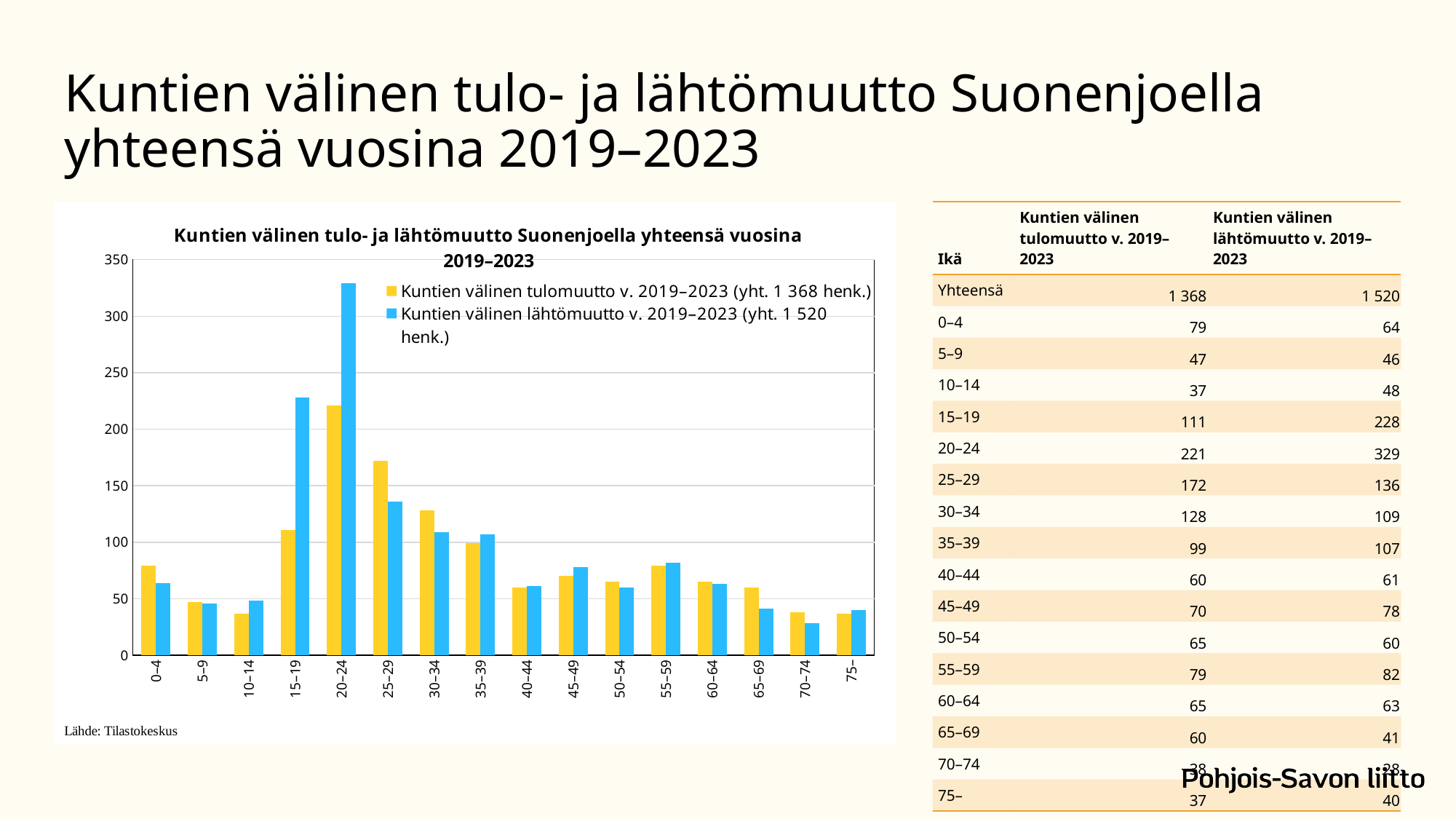
What is the difference between lähtömuutto and tulomuutto for the 15–19 age group? 117 For the 0–4 age group, which is larger: tulomuutto or lähtömuutto? tulomuutto According to the legend, what is the total number of persons for Kuntien välinen lähtömuutto v. 2019–2023? 1 520 henk. Do the values for Kuntien välinen tulomuutto rise or fall from the 20–24 age group to the 40–44 age group? fall What is the value of Kuntien välinen tulomuutto v. 2019–2023 for the 25–29 age group? 172 Which age group has the highest value for Kuntien välinen lähtömuutto v. 2019–2023? 20–24 How many series does the chart legend list? 2 Is the value of Kuntien välinen lähtömuutto for the 15–19 age group greater or less than 200? greater What kind of chart is shown on the slide? bar chart What is the value of Kuntien välinen lähtömuutto v. 2019–2023 for the 20–24 age group? 329 How many age groups are shown on the x axis of the chart? 16 Which age group has the lowest value for Kuntien välinen lähtömuutto v. 2019–2023? 70–74